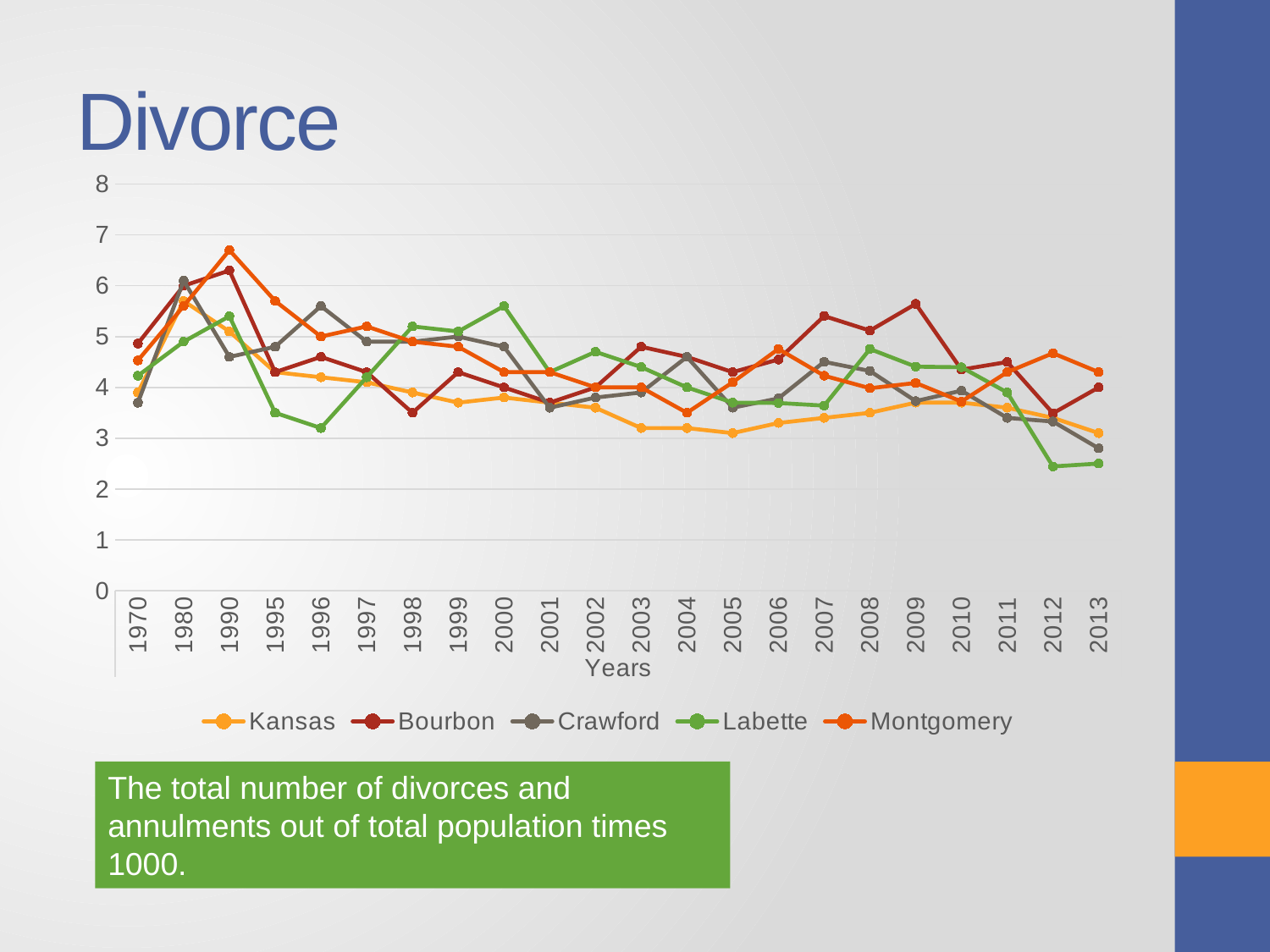
What kind of chart is shown on the slide? line chart Is the value for Bourbon in 2009 greater or less than 5? greater How many series does the legend list? 5 Is the value for Kansas in 2005 greater or less than 4? less How many years are shown along the x axis? 22 Is the value for Labette in 2012 greater or less than 3? less Does the Kansas line rise or fall from 2009 to 2013? fall Which series has the highest value in 1990? Montgomery In 2000, which is larger, the value for Labette or the value for Kansas? Labette Which series has the lowest value in 2012? Labette What is the title of the x axis? Years